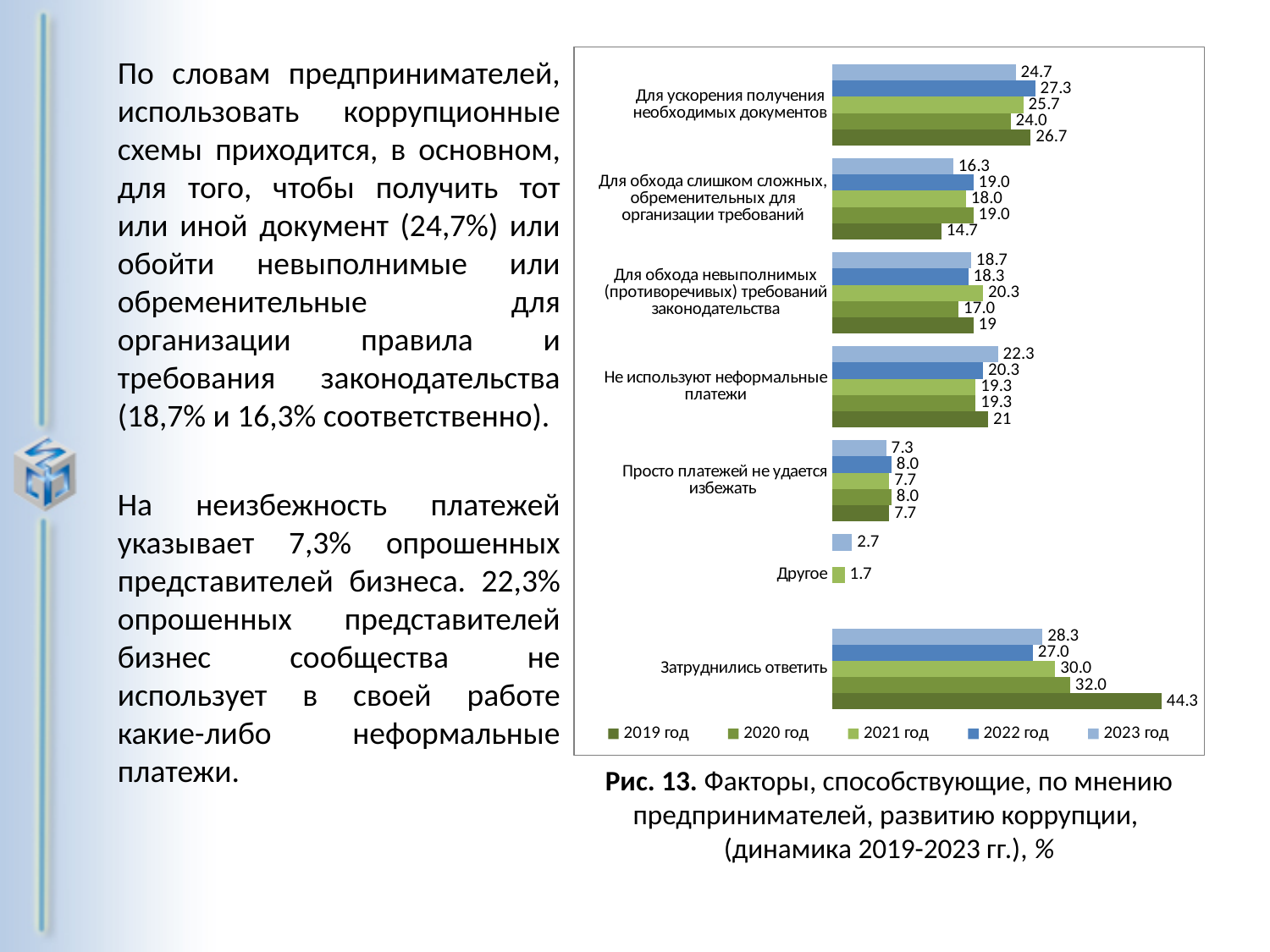
What is the 2023 value for "Для ускорения получения необходимых документов"? 24.7 How many categories are shown on the chart? 7 Which is larger for "Для ускорения получения необходимых документов": the 2022 value or the 2020 value? 2022 год What is the 2023 value for "Другое"? 2.7 Which year has the highest value for "Затруднились ответить"? 2019 год What is the 2019 value for "Затруднились ответить"? 44.3 What is the 2023 value for "Просто платежей не удается избежать"? 7.3 What is the 2023 value for "Не используют неформальные платежи"? 22.3 How many series does the legend list? 5 What is the difference between the 2019 and 2020 values for "Затруднились ответить"? 12.3 What kind of chart is shown on the slide? Bar chart Which year has the lowest value for "Для обхода слишком сложных, обременительных для организации требований"? 2019 год